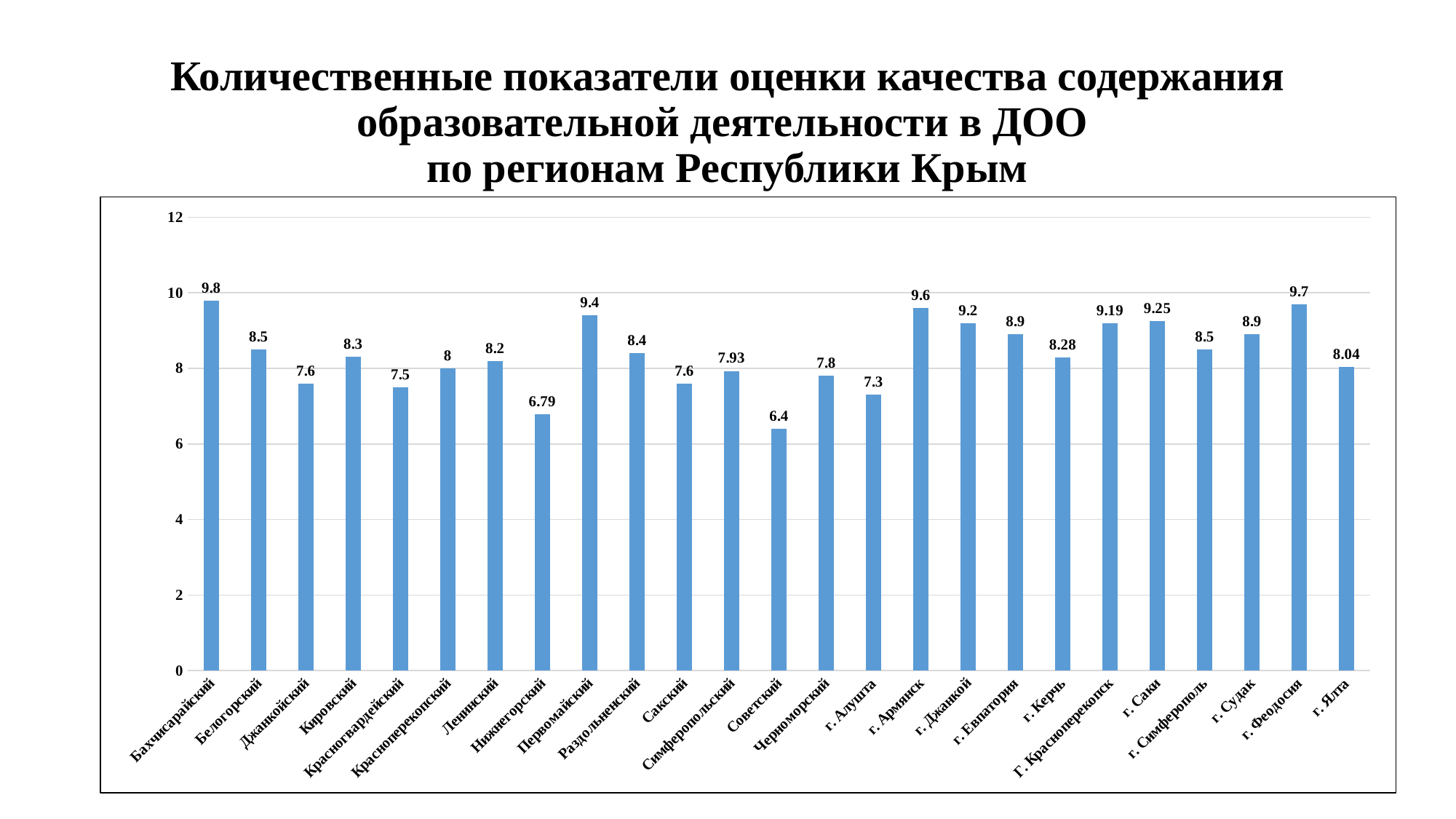
Which region has the lowest value? Советский What is the difference between the values for г. Феодосия and г. Армянск? 0.1 What is the value for Бахчисарайский? 9.8 How many regions are shown on the chart? 25 Is the value for Советский greater or less than 8? less What is the difference between the values for Первомайский and Симферопольский? 1.47 What is the value for г. Керчь? 8.28 What is the value for г. Ялта? 8.04 Which is larger, the value for г. Саки or the value for г. Джанкой? г. Саки What is the value for Нижнегорский? 6.79 What kind of chart is shown on the slide? bar chart Which region has the highest value? Бахчисарайский